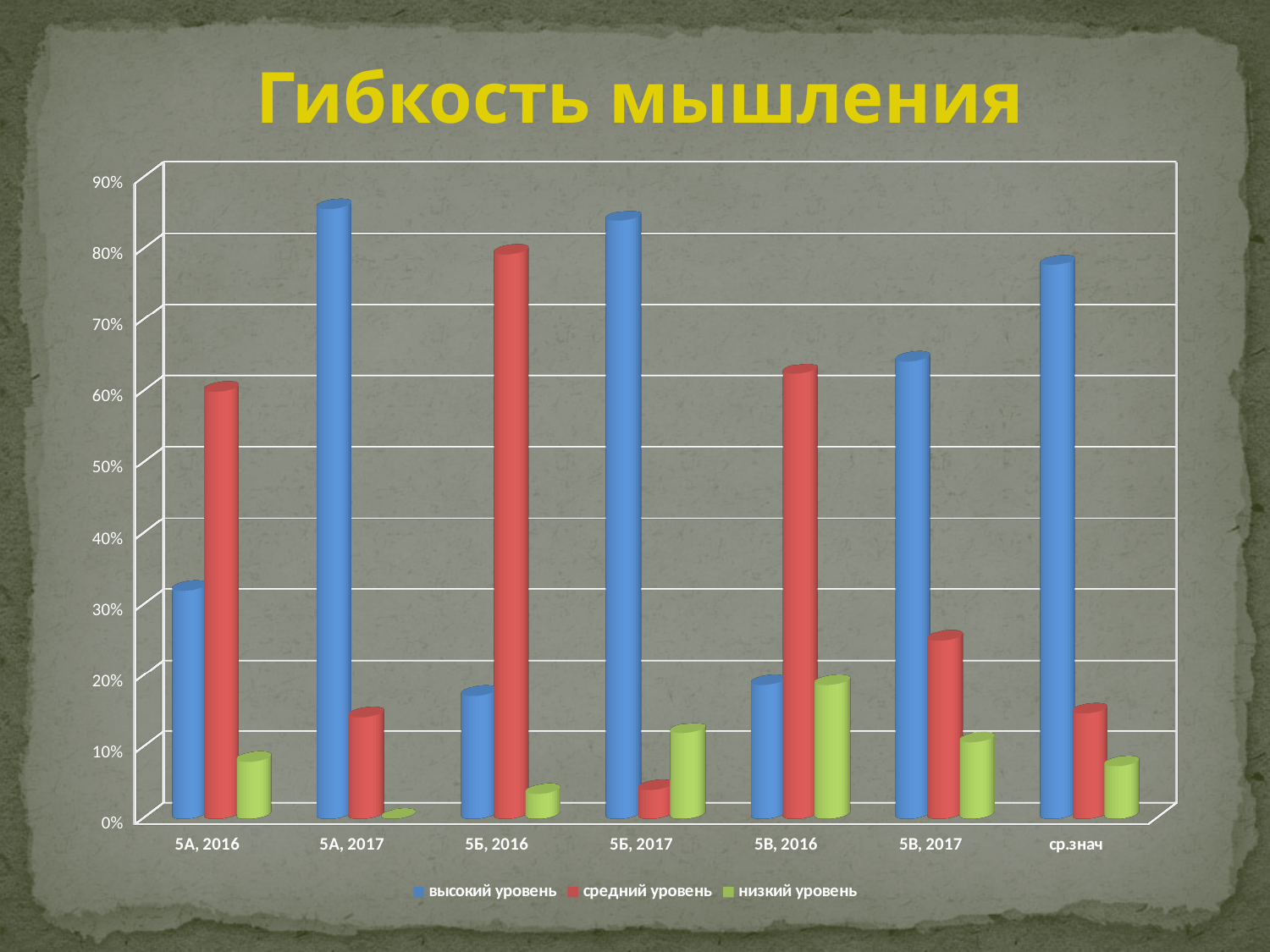
In 5А, 2016, which is larger: высокий уровень or средний уровень? средний уровень How many categories are shown along the x axis? 7 Is the value for средний уровень in 5Б, 2016 greater or less than 70%? greater Which series is shown in green? низкий уровень Which category has the highest value for средний уровень? 5Б, 2016 What kind of chart is shown on the slide? bar chart Which category has the lowest value for низкий уровень? 5А, 2017 Is the value for высокий уровень in 5А, 2016 greater or less than 40%? less Is the value for низкий уровень in 5В, 2016 greater or less than 30%? less What is the title of the chart? Гибкость мышления How many series does the legend list? 3